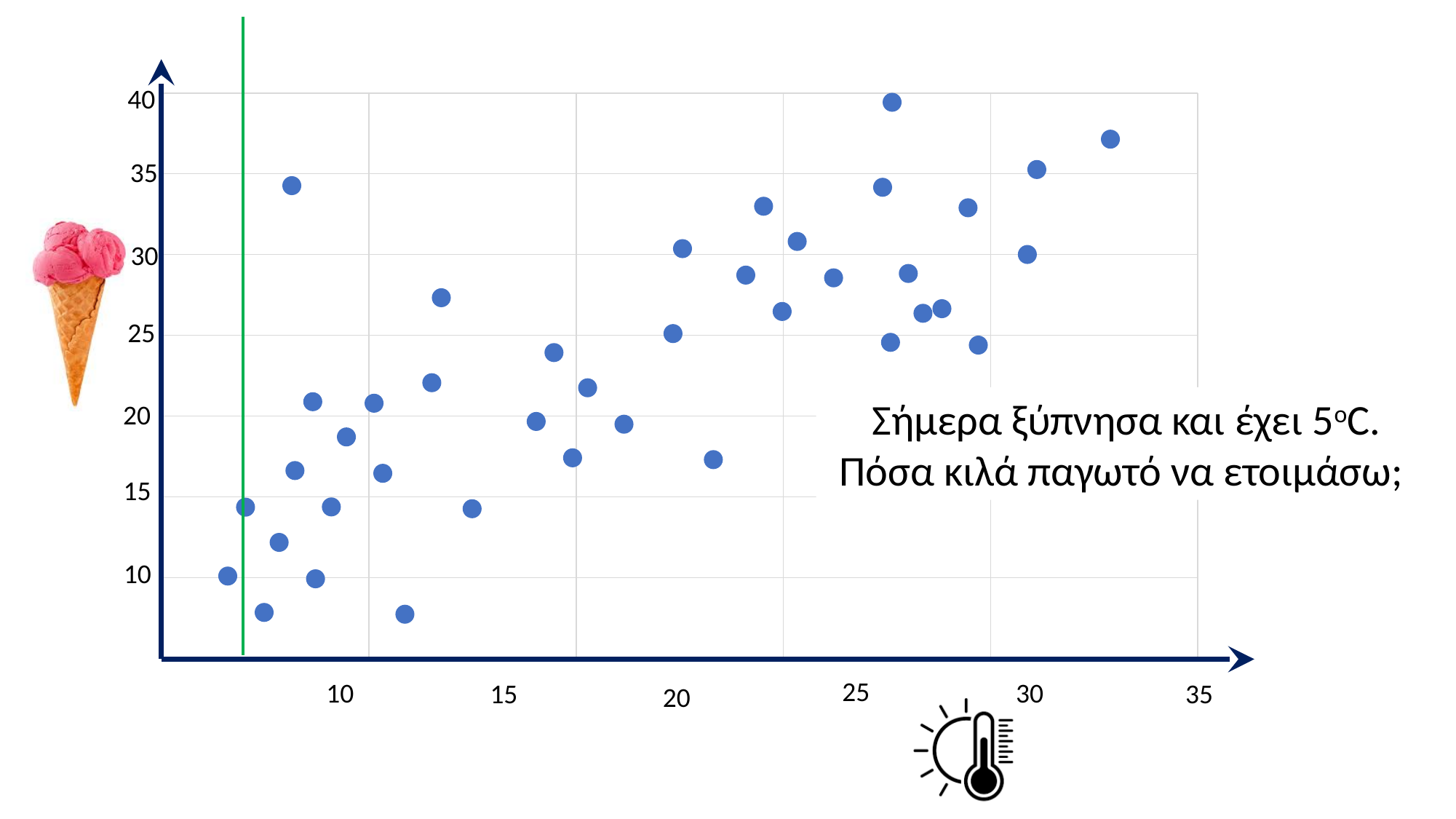
Is the x value of the highest point on the chart greater or less than 25? greater What is the largest value labelled on the x axis? 35 Do the y values of the points generally rise or fall as x increases along the x axis? rise What kind of chart is shown on the slide? scatter plot Is the y value of the lowest point on the chart greater or less than 10? less Is the y value of the rightmost point on the chart greater or less than 35? greater What is the largest value labelled on the y axis? 40